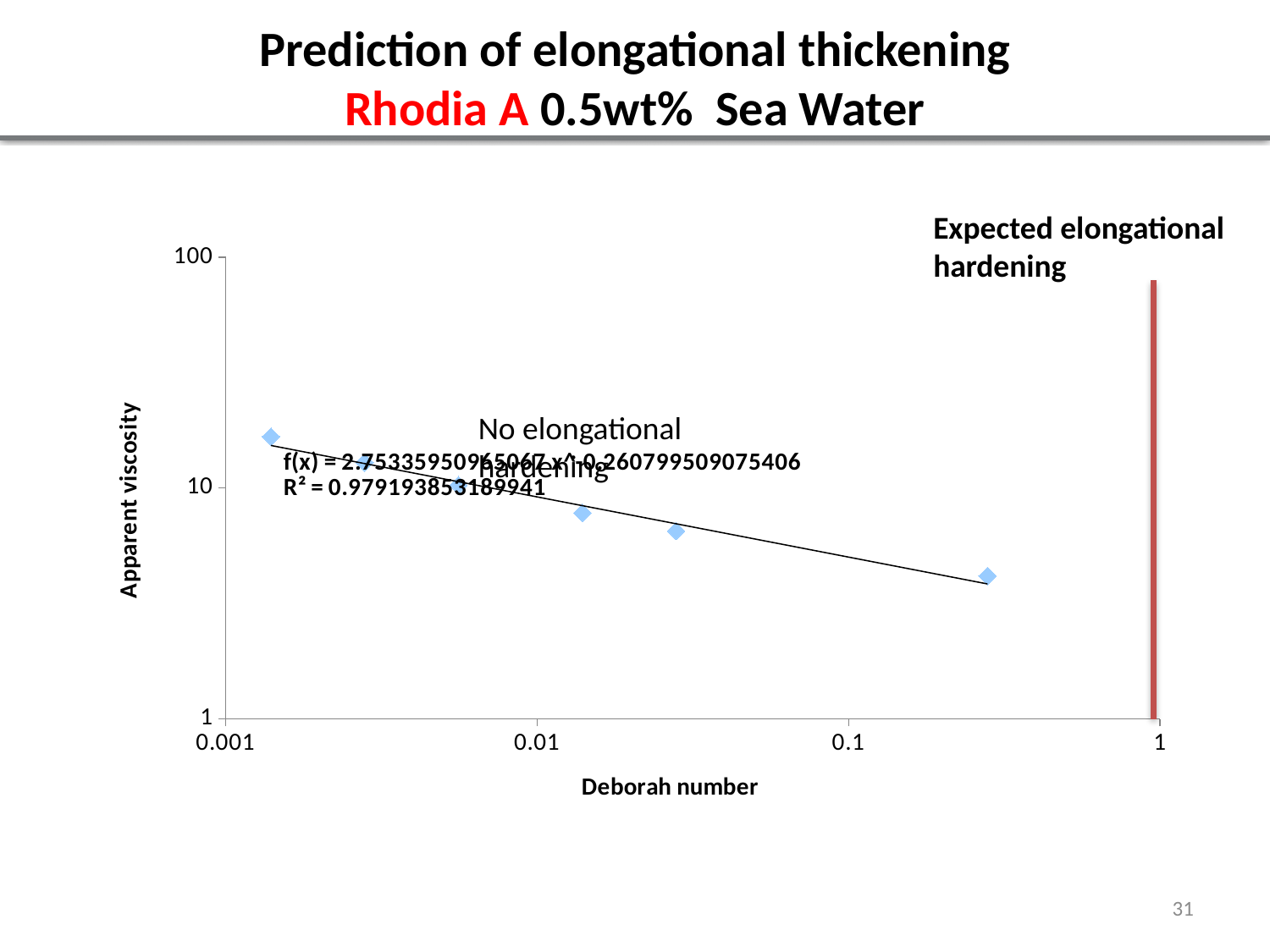
Is the apparent viscosity of the leftmost data point greater or less than 10? greater Does apparent viscosity rise or fall as the Deborah number increases? Fall What is the lowest value shown on the y axis? 1 Is the apparent viscosity of the rightmost data point (near Deborah number 0.3) greater or less than 10? less What is the label of the y axis? Apparent viscosity What is the highest value shown on the x axis? 1 What R² value is printed for the trendline? R² = 0.979193853189941 Which data point has the highest apparent viscosity, the leftmost or the rightmost? The leftmost What kind of chart is shown on the slide? Scatter chart What is the label of the x axis? Deborah number How many data points are plotted on the chart? 6 What is the exponent in the fitted trendline equation f(x) = 2.75335950965067 x^? -0.260799509075406